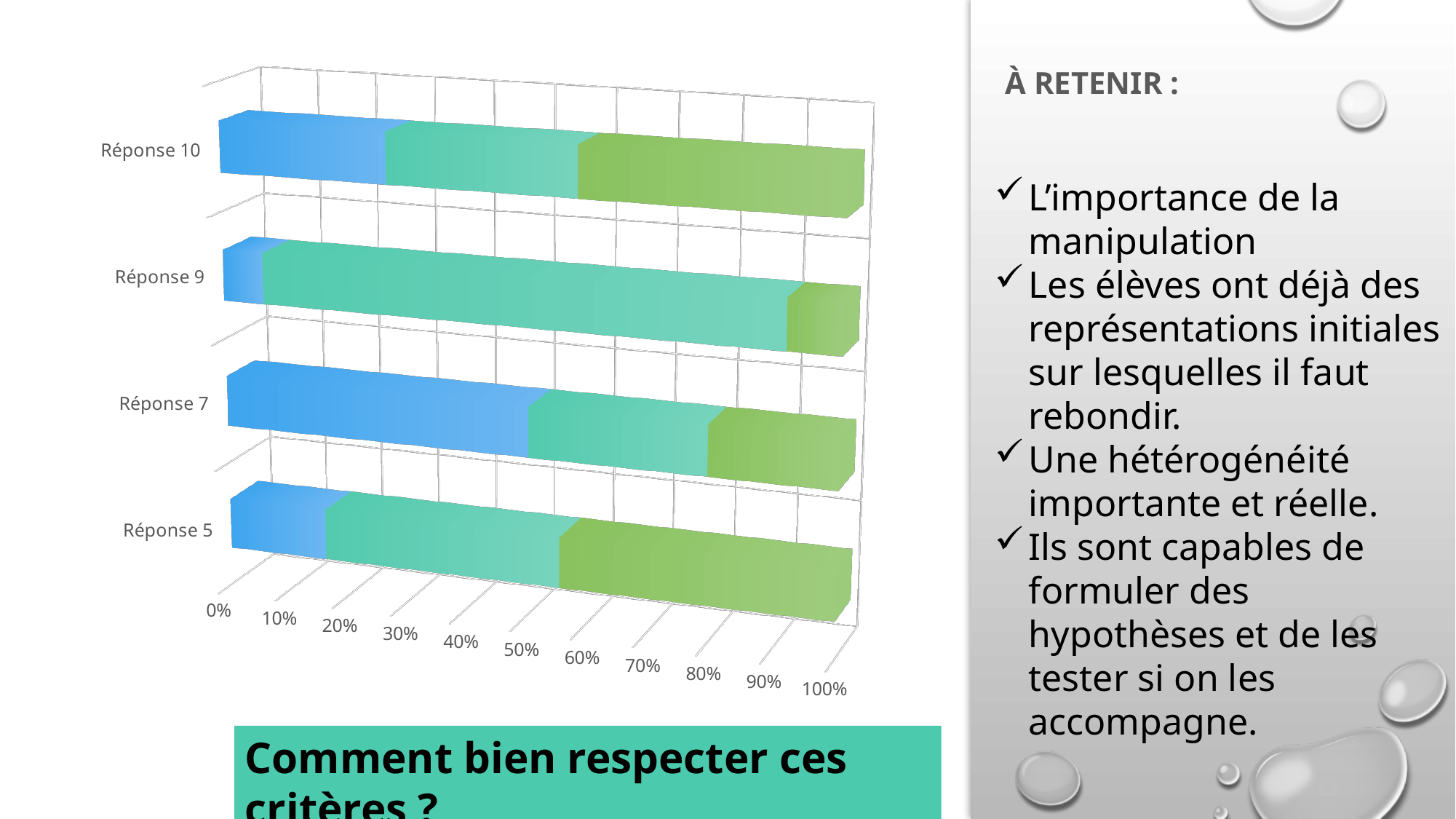
How many categories (Réponse labels) are shown on the chart? 4 Which category has the largest teal (middle) segment? Réponse 9 Which is larger: the blue segment for Réponse 7 or the blue segment for Réponse 5? Réponse 7 Is the teal segment for Réponse 9 greater or less than 50%? greater Is the blue segment for Réponse 9 greater or less than 10%? less Is the blue segment for Réponse 7 greater or less than 30%? greater Which category has the largest blue segment? Réponse 7 Which is larger: the green segment for Réponse 10 or the green segment for Réponse 9? Réponse 10 What is the highest value shown on the percentage axis? 100% Which category has the smallest blue segment? Réponse 9 What kind of chart is shown on the slide? stacked bar chart Which category has the smallest green segment? Réponse 9